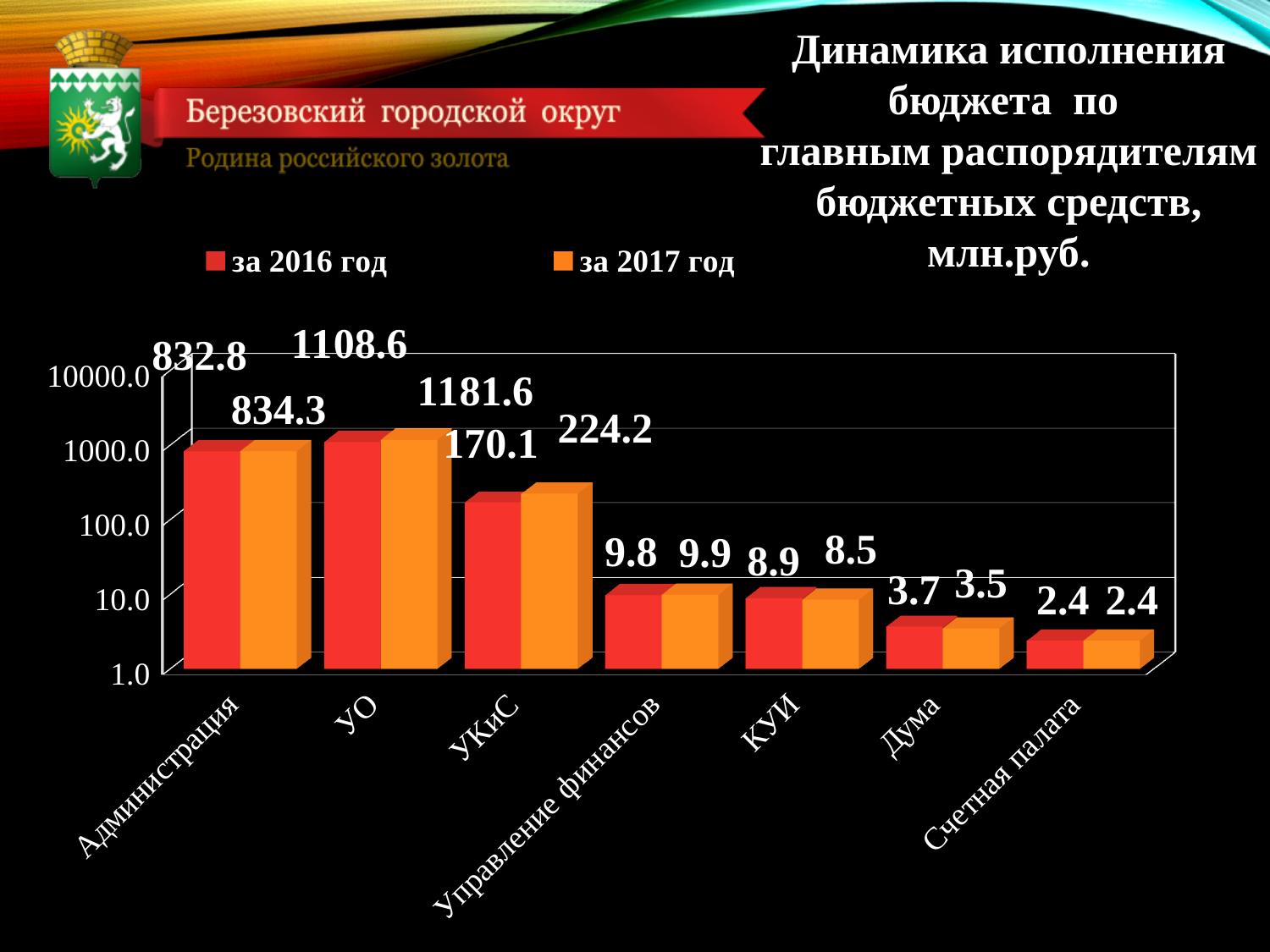
What is the value for УО for за 2017 год? 1181.6 What is the value for Администрация for за 2016 год? 832.8 How many series does the legend list? 2 What kind of chart is shown on the slide? bar chart What is the difference between the за 2017 год and за 2016 год values for УКиС? 54.1 How many categories are shown on the x axis? 7 Which category has the lowest value for за 2016 год? Счетная палата Which category has the highest value for за 2017 год? УО Which is larger for КУИ: the за 2016 год value or the за 2017 год value? за 2016 год What is the value for Дума for за 2016 год? 3.7 What is the value for УКиС for за 2017 год? 224.2 What is the value for Счетная палата for за 2017 год? 2.4